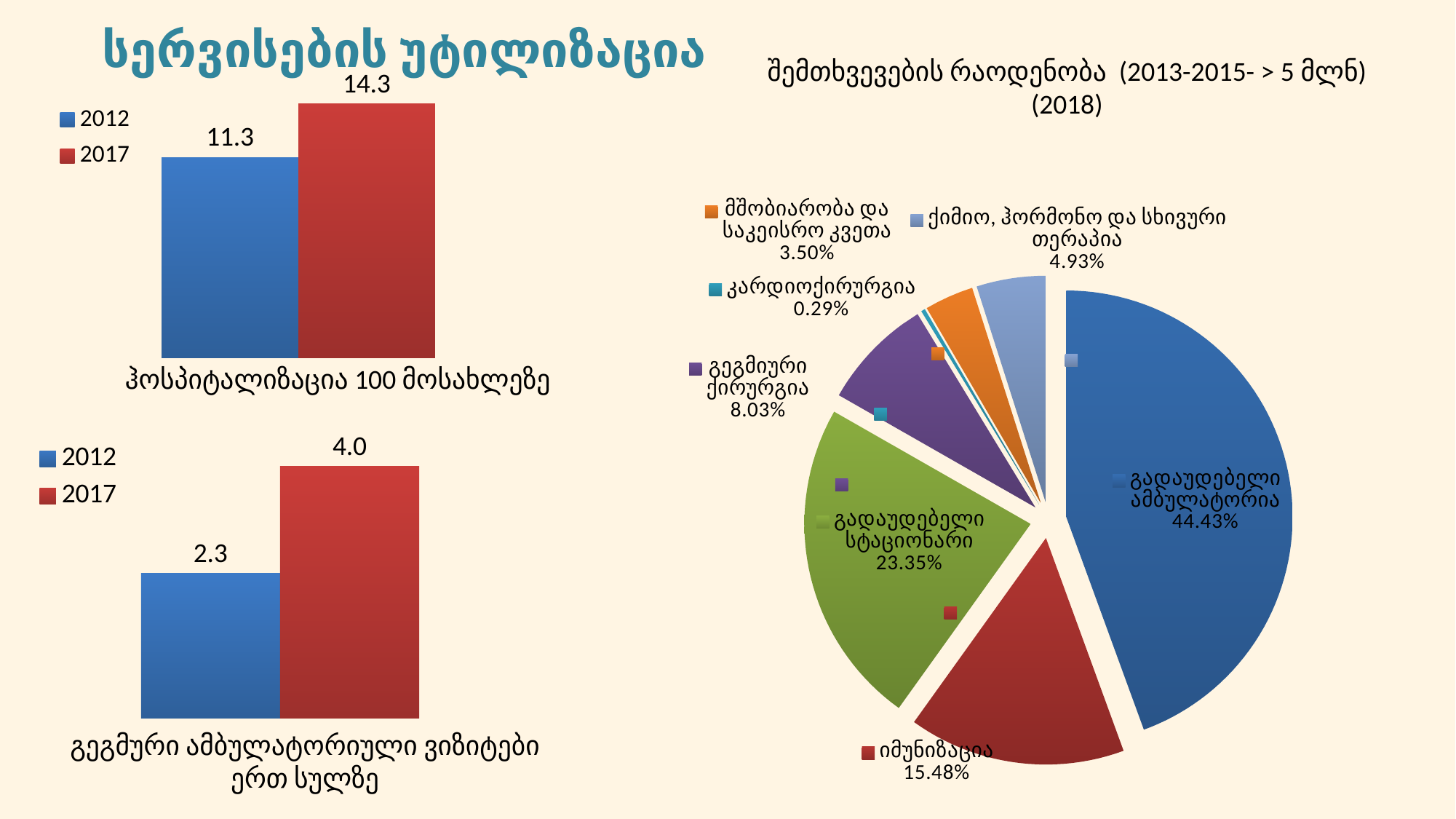
In the top-left bar chart (ჰოსპიტალიზაცია 100 მოსახლეზე), what is the value for 2017? 14.3 In the top-left bar chart (ჰოსპიტალიზაცია 100 მოსახლეზე), what is the difference between the 2017 and 2012 values? 3.0 In the pie chart on the right, what share does იმუნიზაცია have? 15.48% In the bottom-left bar chart (გეგმური ამბულატორიული ვიზიტები ერთ სულზე), what is the value for 2012? 2.3 In the bottom-left bar chart (გეგმური ამბულატორიული ვიზიტები ერთ სულზე), what is the difference between the 2017 and 2012 values? 1.7 In the top-left bar chart (ჰოსპიტალიზაცია 100 მოსახლეზე), what is the value for 2012? 11.3 In the pie chart on the right, which category has the largest share? გადაუდებელი ამბულატორია How many slices does the pie chart on the right have? 7 In the pie chart on the right, which category has the smallest share? კარდიოქირურგია How many series does the legend of the top-left bar chart list? 2 In the bottom-left bar chart (გეგმური ამბულატორიული ვიზიტები ერთ სულზე), which year has the larger value, 2012 or 2017? 2017 What kind of chart is the chart on the right side of the slide (შემთხვევების რაოდენობა)? Pie chart